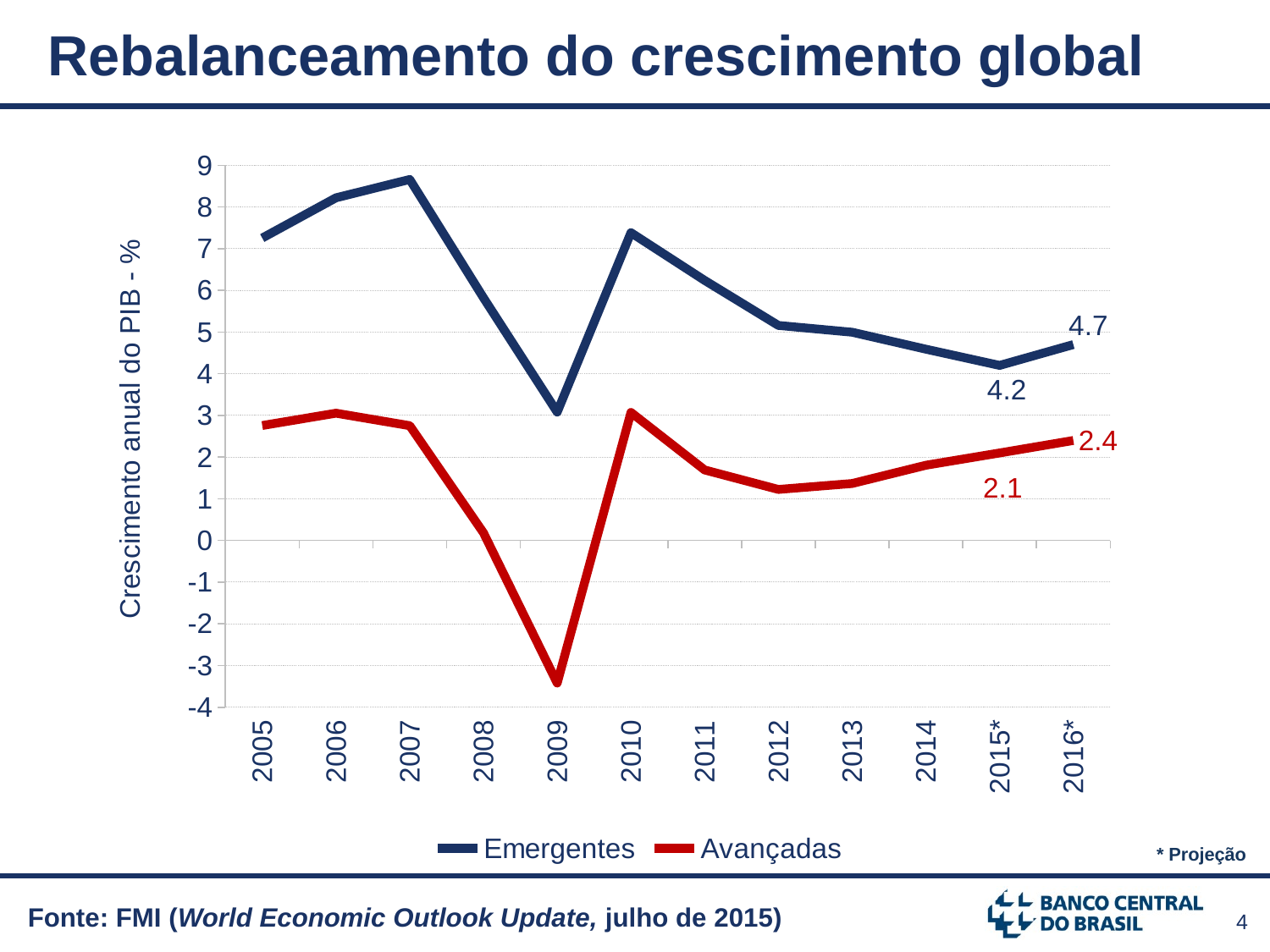
What is the value for Emergentes in 2016*? 4.7 In which year does the Emergentes series reach its highest value? 2007 Is the value for Avançadas in 2009 greater or less than 0? less What is the value for Avançadas in 2015*? 2.1 In which year does the Avançadas series reach its lowest value? 2009 What is the difference between the Emergentes and Avançadas values in 2016*? 2.3 What kind of chart is shown on the slide? Line chart Is the value for Emergentes in 2007 greater or less than 8? greater How many series does the legend list? 2 By how much does the Avançadas value change from 2015* to 2016*? 0.3 Which series has the larger value in 2015*, Emergentes or Avançadas? Emergentes What is the value for Emergentes in 2015*? 4.2